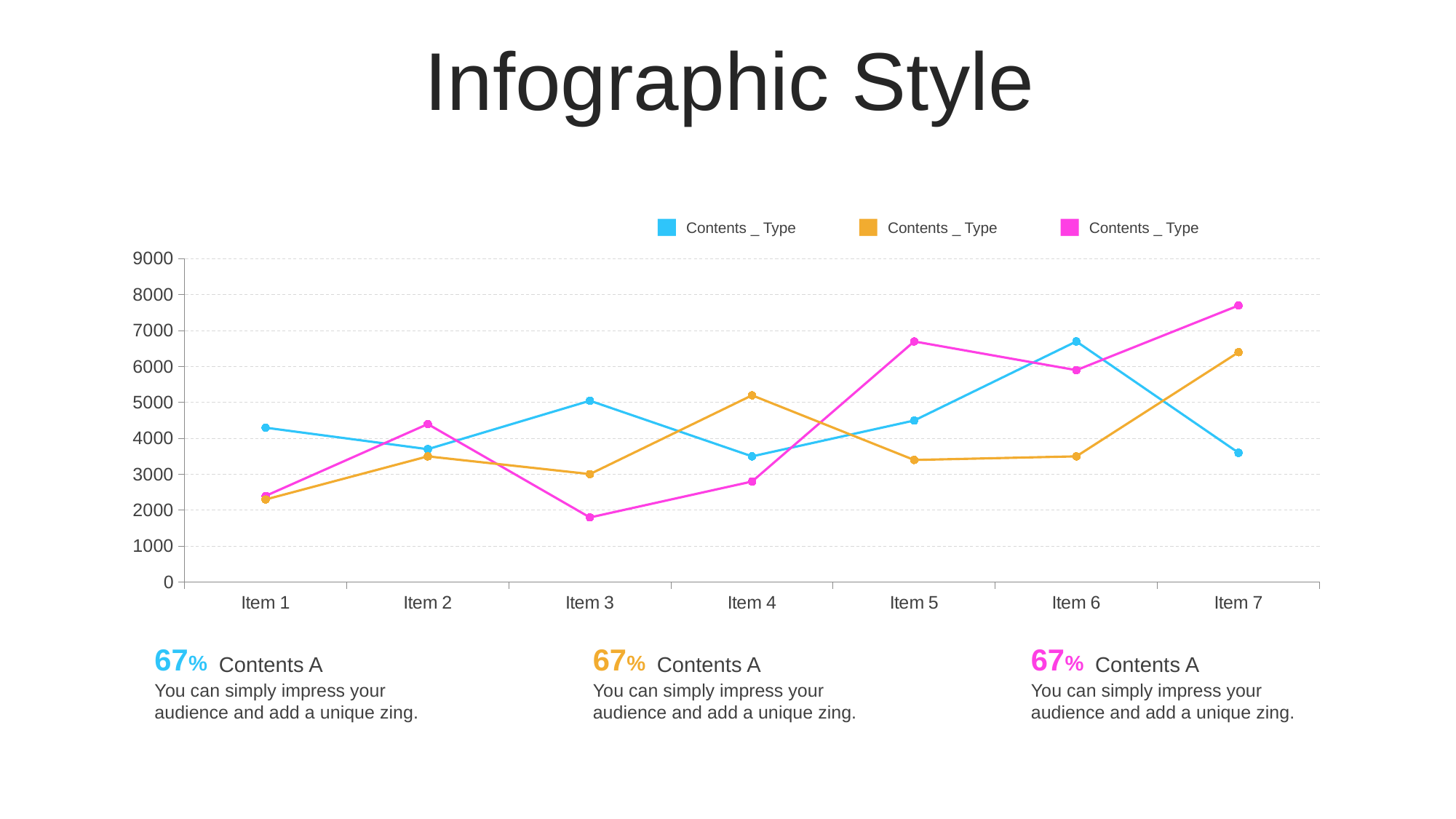
Is the value of the orange line at Item 7 greater or less than 6000? greater Is the value of the blue line at Item 6 greater or less than 6000? greater Is the value of the orange line at Item 1 greater or less than 3000? less At which item does the pink line reach its highest value? Item 7 At which item does the pink line reach its lowest value? Item 3 At Item 4, which line has the larger value, the orange line or the blue line? orange At which item does the blue line reach its highest value? Item 6 What kind of chart is shown on the slide? line chart What is the title of the slide containing the chart? Infographic Style How many series does the legend list? 3 How many items are plotted along the x axis? 7